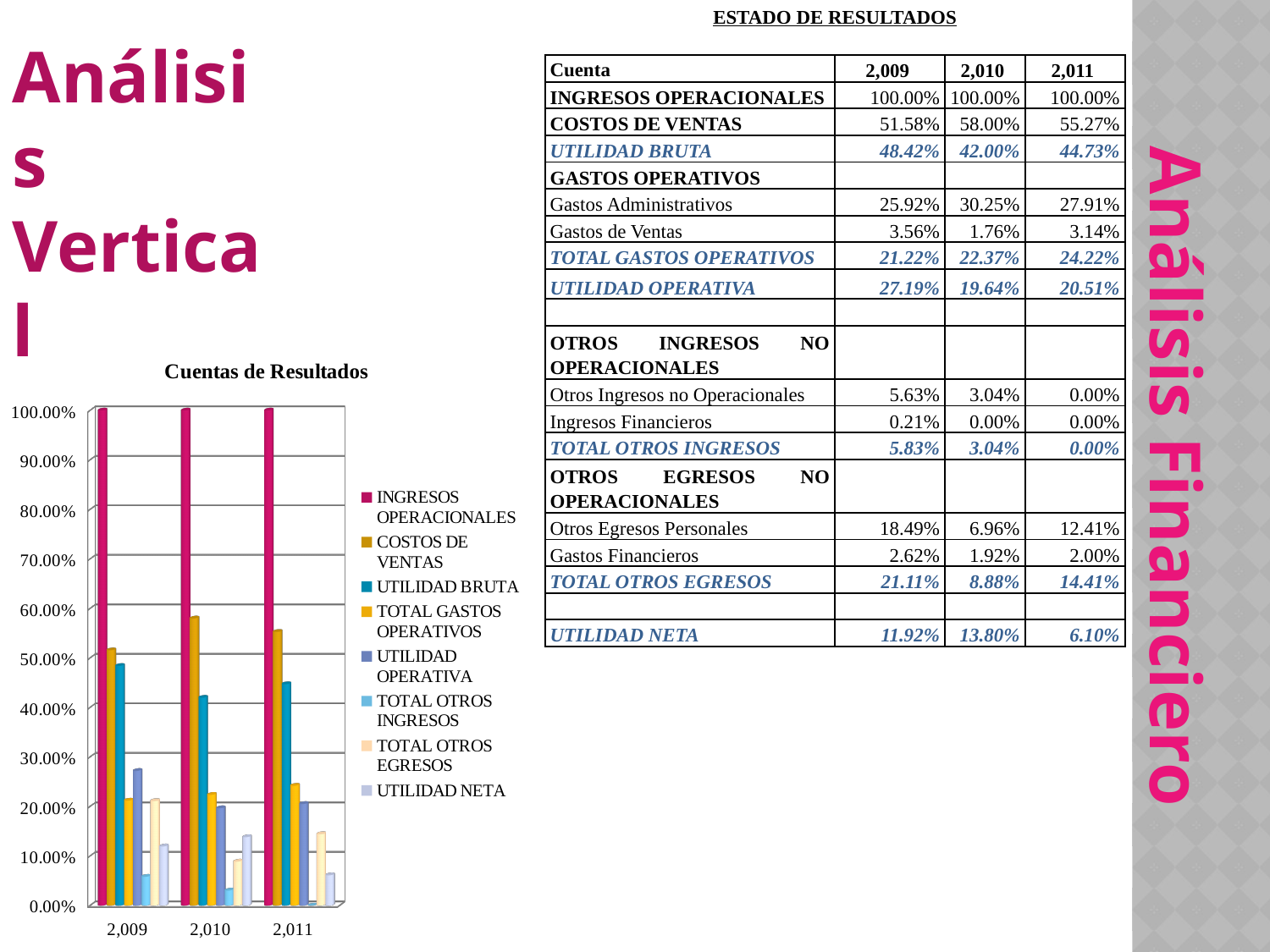
In the 'Cuentas de Resultados' chart, which is larger for 2,011: COSTOS DE VENTAS or UTILIDAD BRUTA? COSTOS DE VENTAS In the 'Cuentas de Resultados' chart, what is the value of INGRESOS OPERACIONALES for 2,009? 100.00% In the 'Cuentas de Resultados' chart, which series has the lowest bar for 2,011? TOTAL OTROS INGRESOS What kind of chart is 'Cuentas de Resultados'? bar chart How many years (categories) are shown on the x axis of the 'Cuentas de Resultados' chart? 3 In the 'Cuentas de Resultados' chart, which series has the highest bar for 2,010? INGRESOS OPERACIONALES In the 'Cuentas de Resultados' chart, is the value of COSTOS DE VENTAS for 2,010 greater or less than 50.00%? greater In the 'Cuentas de Resultados' chart, is the value of UTILIDAD NETA for 2,011 greater or less than 10.00%? less In the 'Cuentas de Resultados' chart, does TOTAL OTROS INGRESOS rise or fall from 2,009 to 2,011? fall In the 'Cuentas de Resultados' chart, is the value of UTILIDAD BRUTA for 2,010 greater or less than 50.00%? less What is the title of the chart on the slide? Cuentas de Resultados How many series does the legend of the 'Cuentas de Resultados' chart list? 8